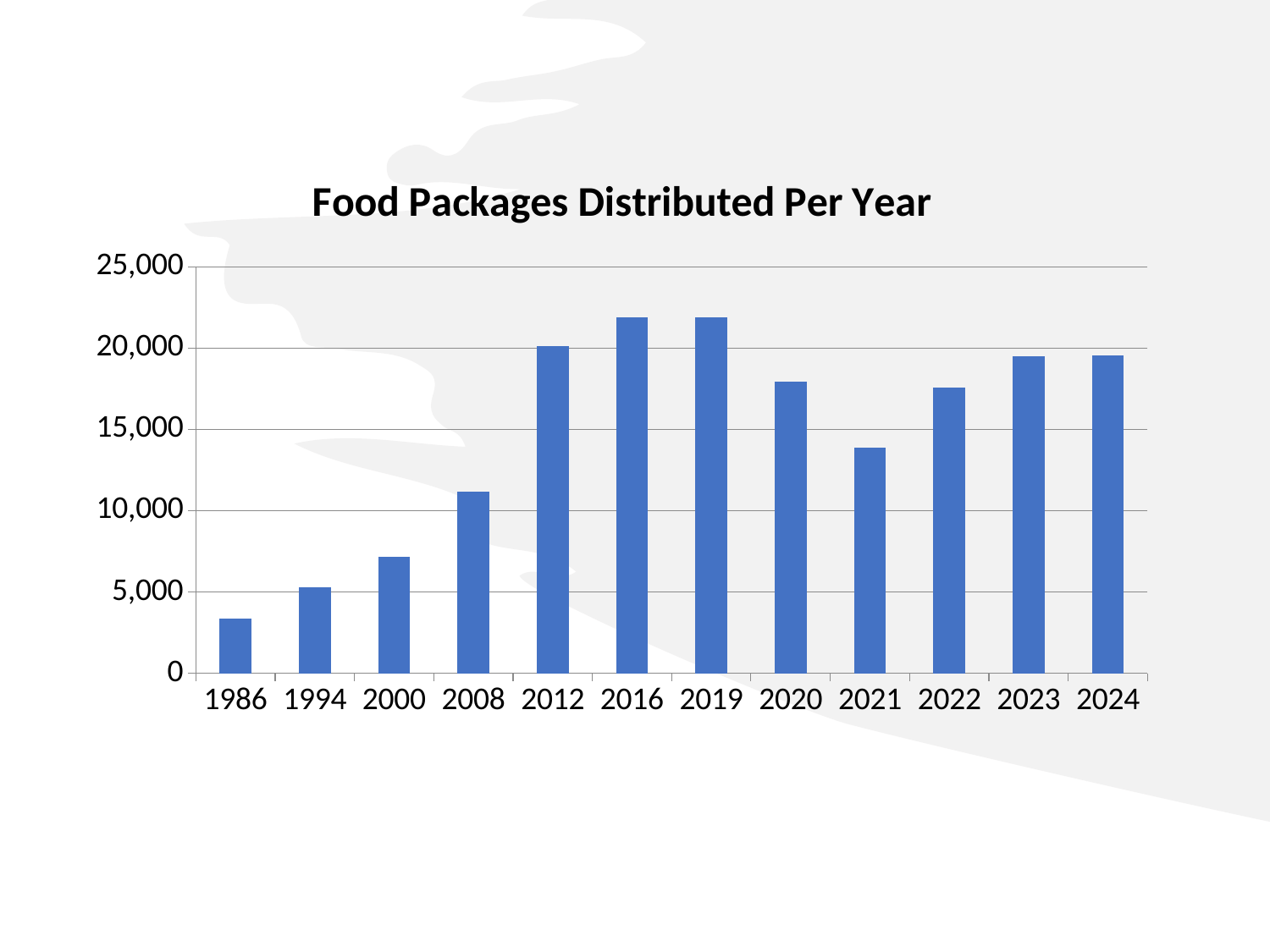
Which year has the higher value, 2020 or 2021? 2020 Which year has the higher value, 2008 or 2012? 2012 Which year has the lowest number of food packages distributed? 1986 Is the value for 2016 greater or less than 20,000? greater Is the value for 2008 greater or less than 10,000? greater Is the value for 1986 greater or less than 5,000? less Do the values rise or fall from 1986 to 2016? rise What is the title of the chart? Food Packages Distributed Per Year What type of chart is shown on the slide? Bar chart How many years are shown on the x axis of the chart? 12